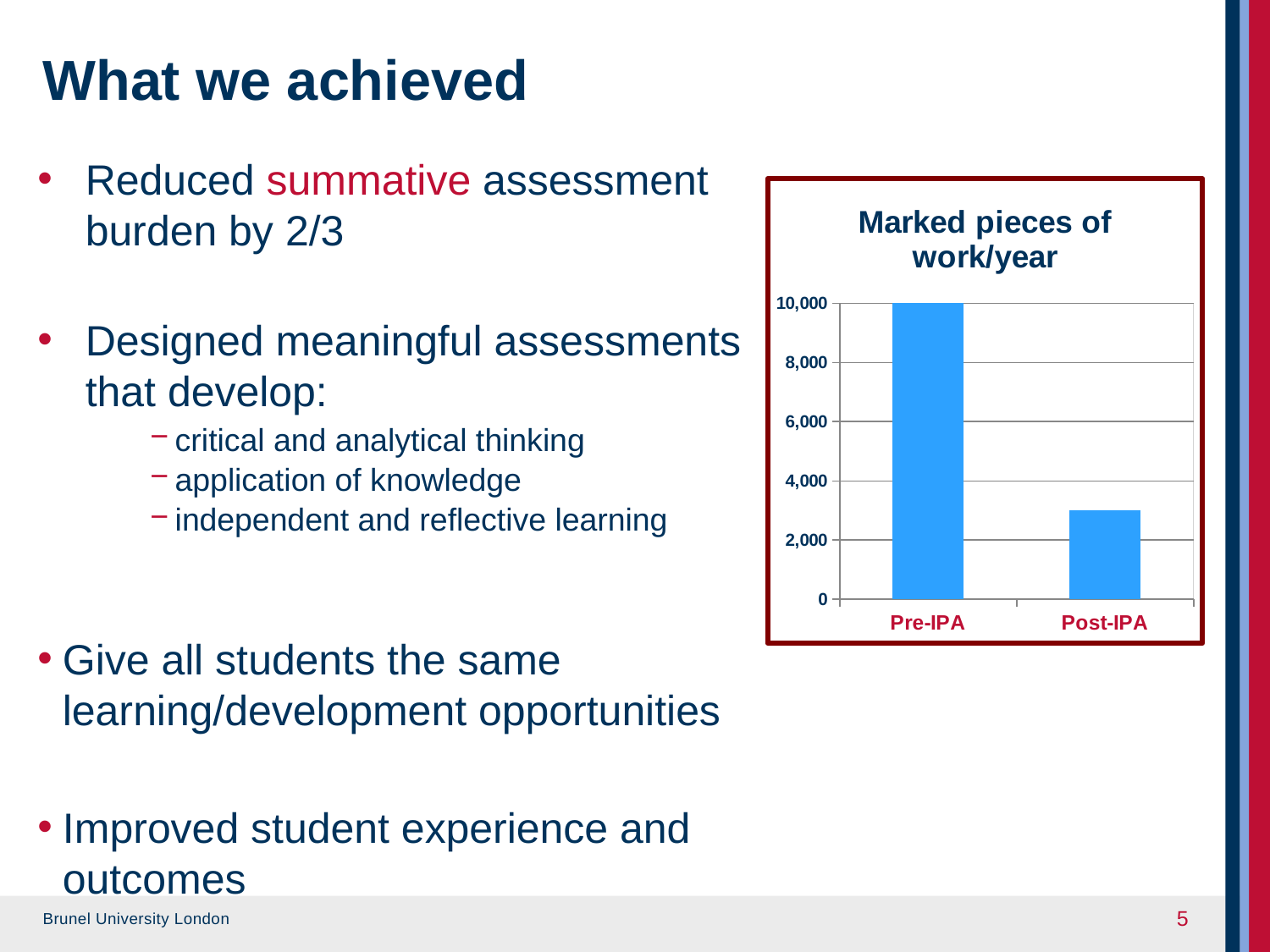
Which category has the highest value in the Marked pieces of work/year chart? Pre-IPA What is the highest value shown on the vertical axis of the chart? 10,000 Is the value for Post-IPA greater or less than 2,000? greater What kind of chart is shown on the slide? bar chart Is the value for Pre-IPA greater or less than 8,000? greater What is the title of the chart on the slide? Marked pieces of work/year Which is larger in the Marked pieces of work/year chart, Pre-IPA or Post-IPA? Pre-IPA Is the value for Post-IPA greater or less than 4,000? less What is the value for Pre-IPA in the Marked pieces of work/year chart? 10,000 How many categories are shown in the Marked pieces of work/year chart? 2 Which category has the lowest value in the Marked pieces of work/year chart? Post-IPA Do the values rise or fall from Pre-IPA to Post-IPA? fall